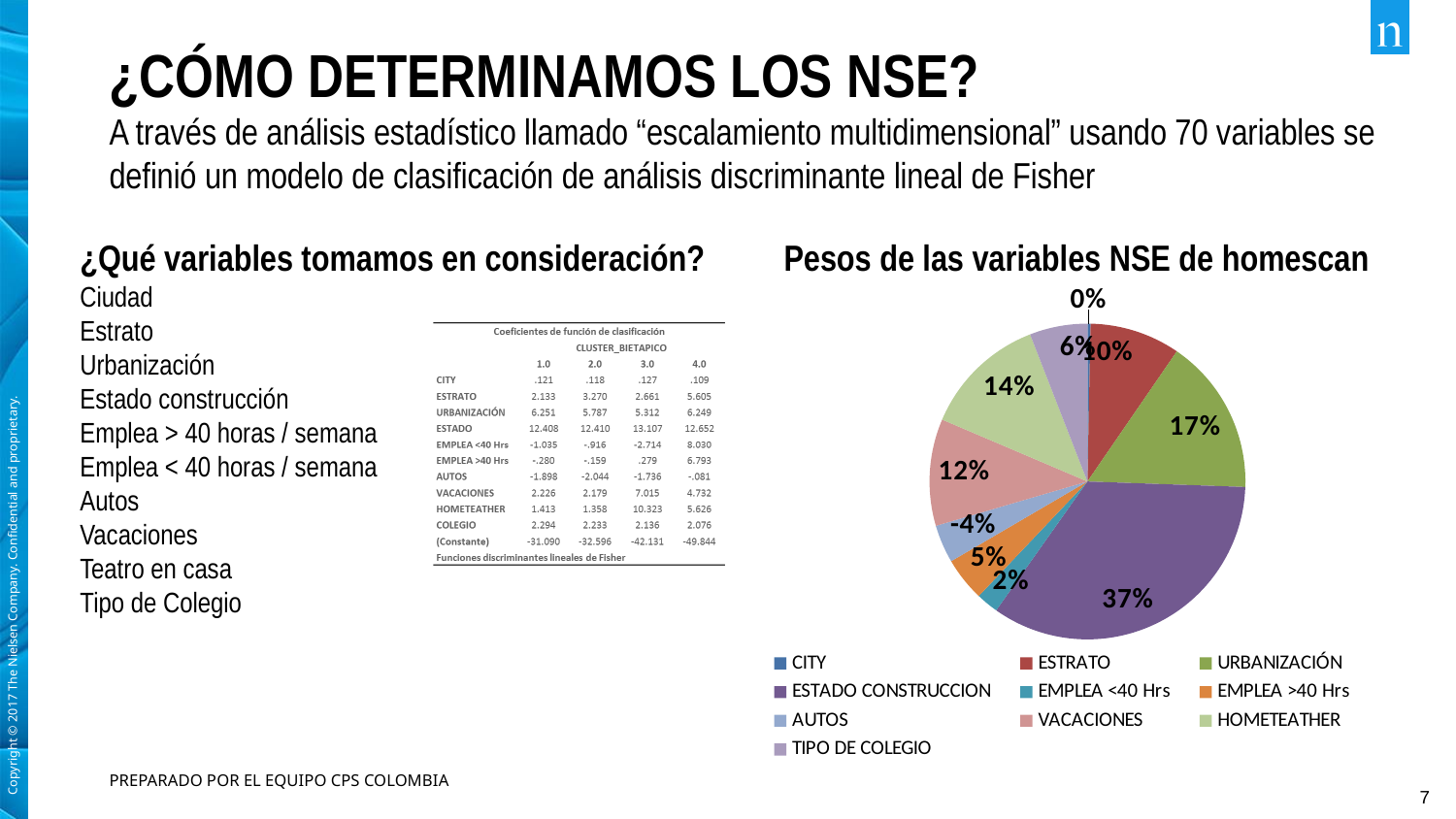
In the pie chart, what is the difference between the ESTADO CONSTRUCCION and URBANIZACIÓN percentages? 20% In the pie chart, what percentage is shown for EMPLEA >40 Hrs? 5% What kind of chart is shown under the title "Pesos de las variables NSE de homescan"? pie chart Which category has the lowest value in the pie chart? AUTOS How many categories does the pie chart's legend list? 10 Which category has the largest slice in the pie chart? ESTADO CONSTRUCCION In the pie chart, what percentage is shown for URBANIZACIÓN? 17% In the pie chart, what percentage is shown for ESTADO CONSTRUCCION? 37% In the pie chart, which is larger: HOMETEATHER or VACACIONES? HOMETEATHER What is the title of the pie chart on the slide? Pesos de las variables NSE de homescan In the pie chart, what percentage is shown for VACACIONES? 12% In the pie chart, what percentage is shown for HOMETEATHER? 14%